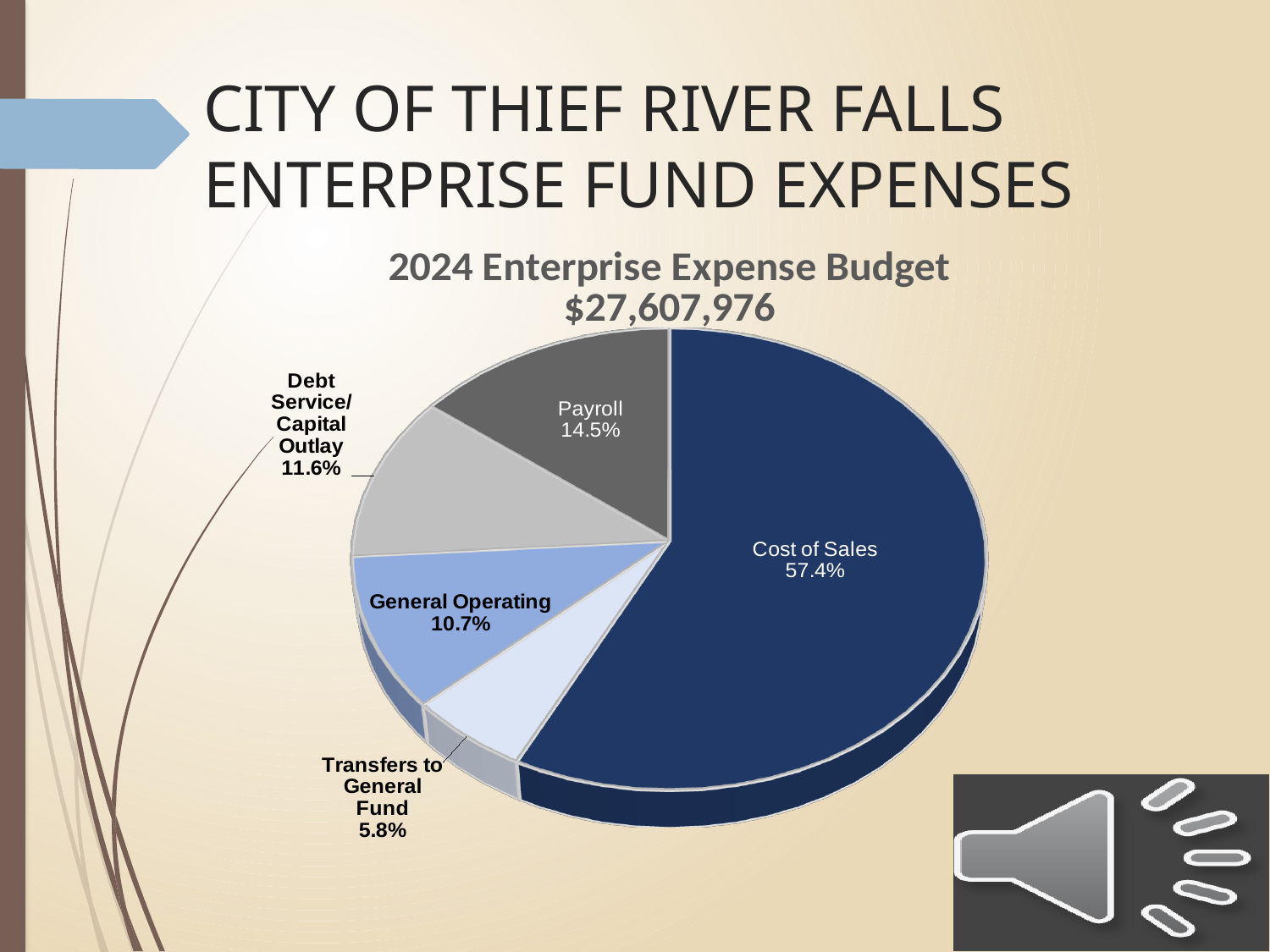
What percentage is shown for General Operating? 10.7% What is the difference in percentage points between Cost of Sales and Payroll? 42.9 What total budget amount is shown in the chart title? $27,607,976 Which category has the largest share of the pie? Cost of Sales Which category has the smallest share of the pie? Transfers to General Fund What percentage of the pie is Payroll? 14.5% What kind of chart is shown on the slide? Pie chart What share does Debt Service/Capital Outlay represent? 11.6% Which is larger, Debt Service/Capital Outlay or General Operating? Debt Service/Capital Outlay How many slices does the pie chart have? 5 What share of the 2024 Enterprise Expense Budget is Cost of Sales? 57.4% What share of the budget is Transfers to General Fund? 5.8%